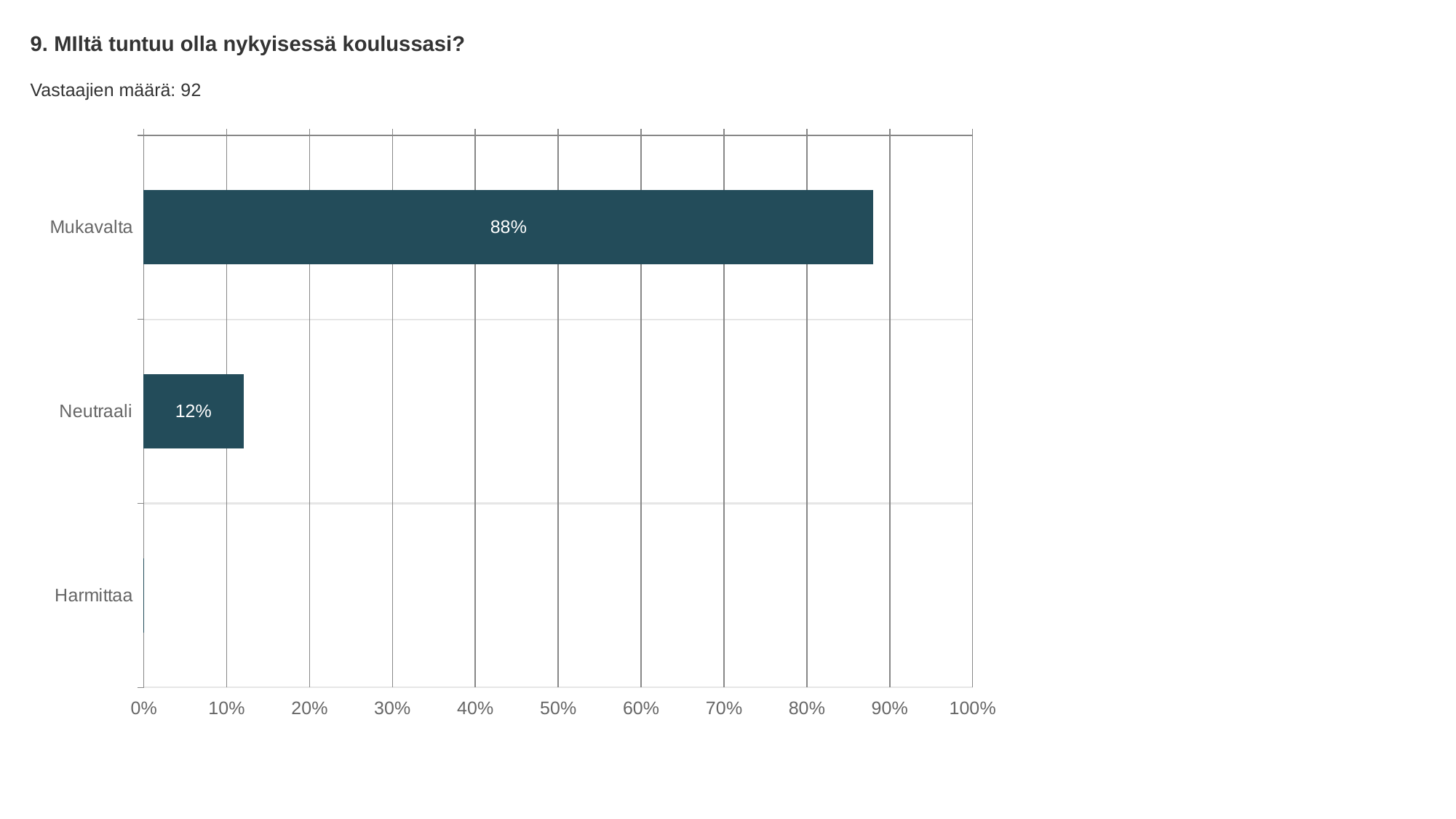
Which category has the lowest value? Harmittaa What is the value for Mukavalta? 88% How many respondents (Vastaajien määrä) are reported on the slide? 92 Is the value for Neutraali greater or less than 20%? less What kind of chart is shown on the slide? bar chart Which category has the highest value? Mukavalta Which is larger, the value for Mukavalta or the value for Neutraali? Mukavalta What is the value for Neutraali? 12% Is the value for Mukavalta greater or less than 80%? greater What is the title of the chart? 9. MIltä tuntuu olla nykyisessä koulussasi? How many categories are shown in the chart? 3 What is the difference between the values for Mukavalta and Neutraali? 76%